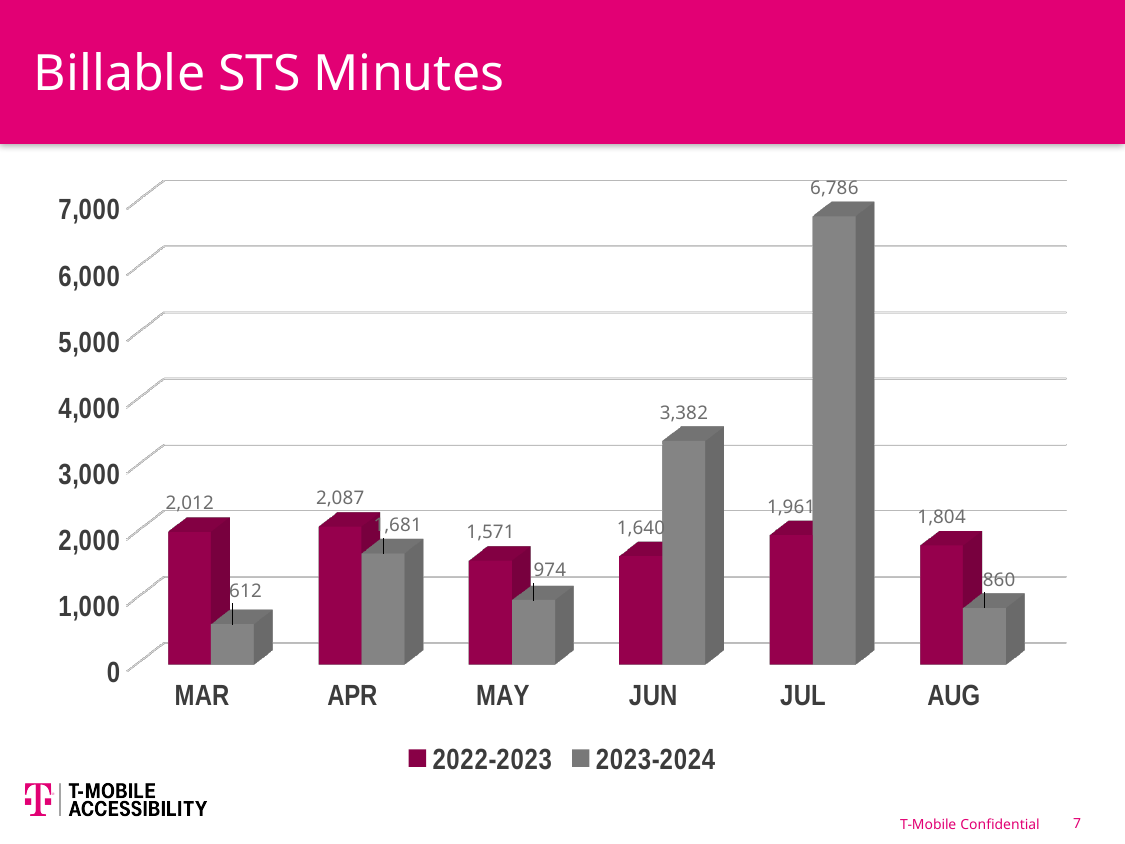
How many series does the legend list? 2 Which is larger for AUG: the 2022-2023 value or the 2023-2024 value? 2022-2023 Is the value for APR in the 2023-2024 series greater or less than 1,000? greater What is the value for MAY in the 2023-2024 series? 974 What kind of chart is shown on the slide? Bar chart What is the value for JUL in the 2023-2024 series? 6,786 Which month has the highest value in the 2023-2024 series? JUL Which month has the lowest value in the 2022-2023 series? MAY What is the difference between the 2023-2024 and 2022-2023 values for JUN? 1,742 Which month has the lowest value in the 2023-2024 series? MAR How many months are shown on the x axis? 6 What is the value for MAR in the 2022-2023 series? 2,012